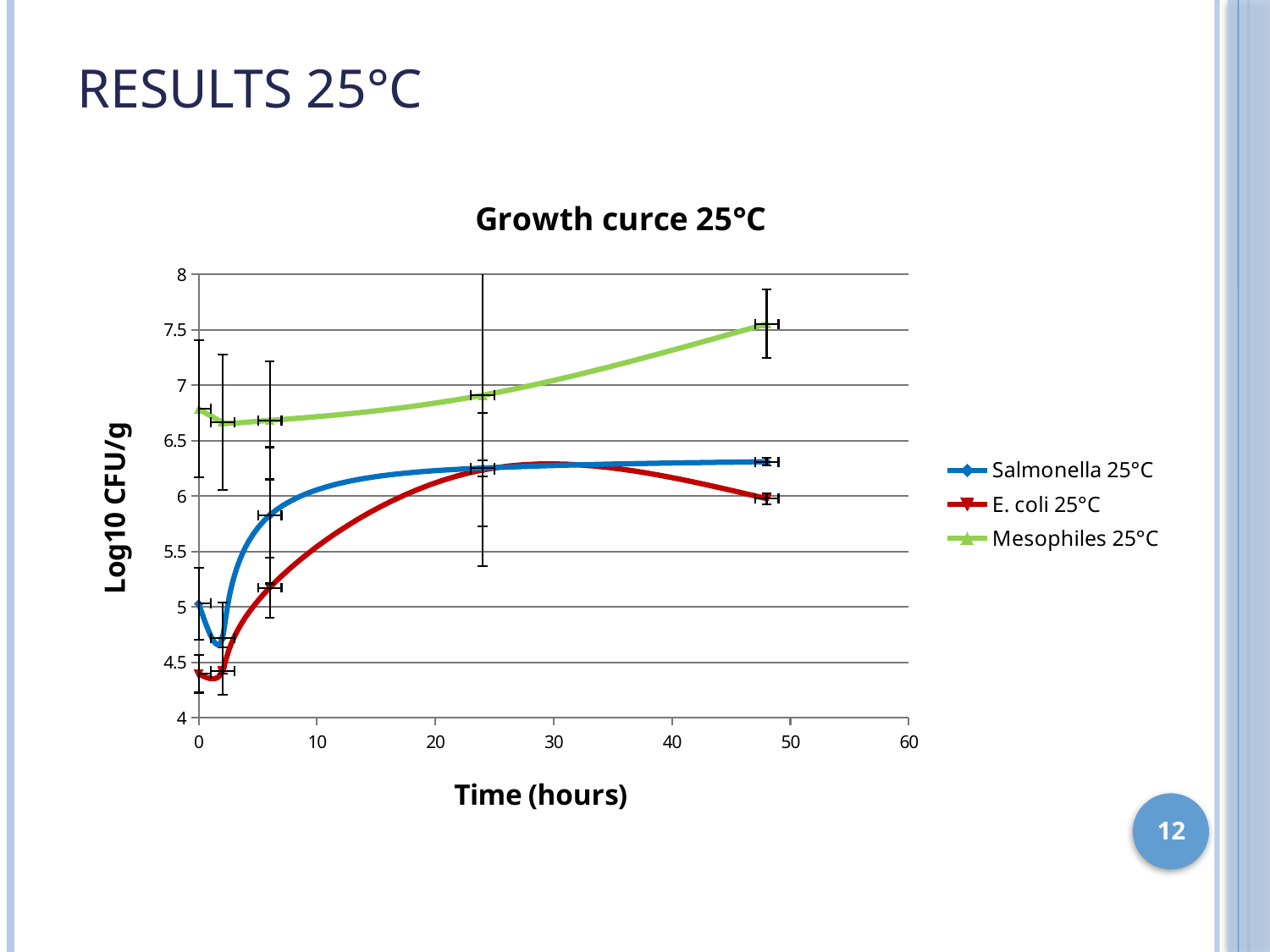
Is the value for Mesophiles 25°C at 0 hours greater or less than 6.5? greater Is the value for Salmonella 25°C at 48 hours greater or less than 6? greater At 48 hours, which series has the higher value: Mesophiles 25°C or Salmonella 25°C? Mesophiles 25°C What is the title of the chart? Growth curce 25°C How many series does the legend list? 3 What kind of chart is shown on the slide? line chart What is the label of the x axis? Time (hours) Which series reaches the highest value on the chart? Mesophiles 25°C Is the value for E. coli 25°C at 6 hours greater or less than 5? greater Does the Mesophiles 25°C series rise or fall between 6 hours and 48 hours? rise At 48 hours, which series has the higher value: Salmonella 25°C or E. coli 25°C? Salmonella 25°C